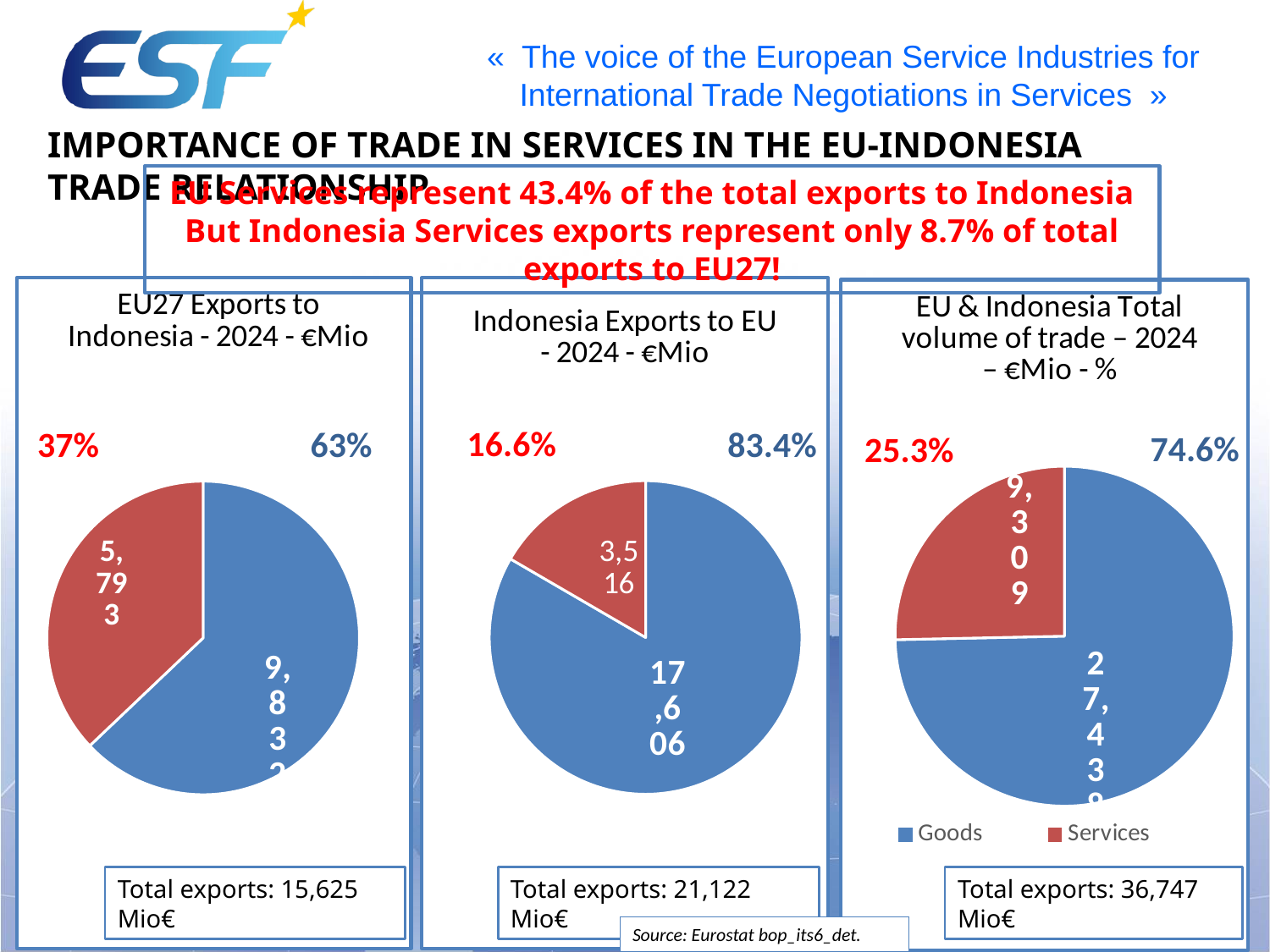
In the Indonesia Exports to EU - 2024 chart, what is the value shown for Services? 3,516 In the EU27 Exports to Indonesia - 2024 chart, what is the value shown for Services? 5,793 In the Indonesia Exports to EU - 2024 chart, what is the difference between the Goods value and the Services value? 14,090 What kind of chart is used on this slide for the EU27 Exports to Indonesia chart? Pie chart In the Indonesia Exports to EU - 2024 chart, what is the value shown for Goods? 17,606 In the EU & Indonesia Total volume of trade - 2024 chart, what is the value shown for Services? 9,309 In the EU & Indonesia Total volume of trade - 2024 chart, what share is Services? 25.3% In the EU27 Exports to Indonesia - 2024 chart, which is larger, Goods or Services? Goods How many entries does the legend list for the EU & Indonesia Total volume of trade chart? 2 In the EU27 Exports to Indonesia - 2024 chart, what share of exports is Services? 37% In the EU & Indonesia Total volume of trade - 2024 chart, which slice is the largest? Goods In the Indonesia Exports to EU - 2024 chart, what share of exports is Goods? 83.4%